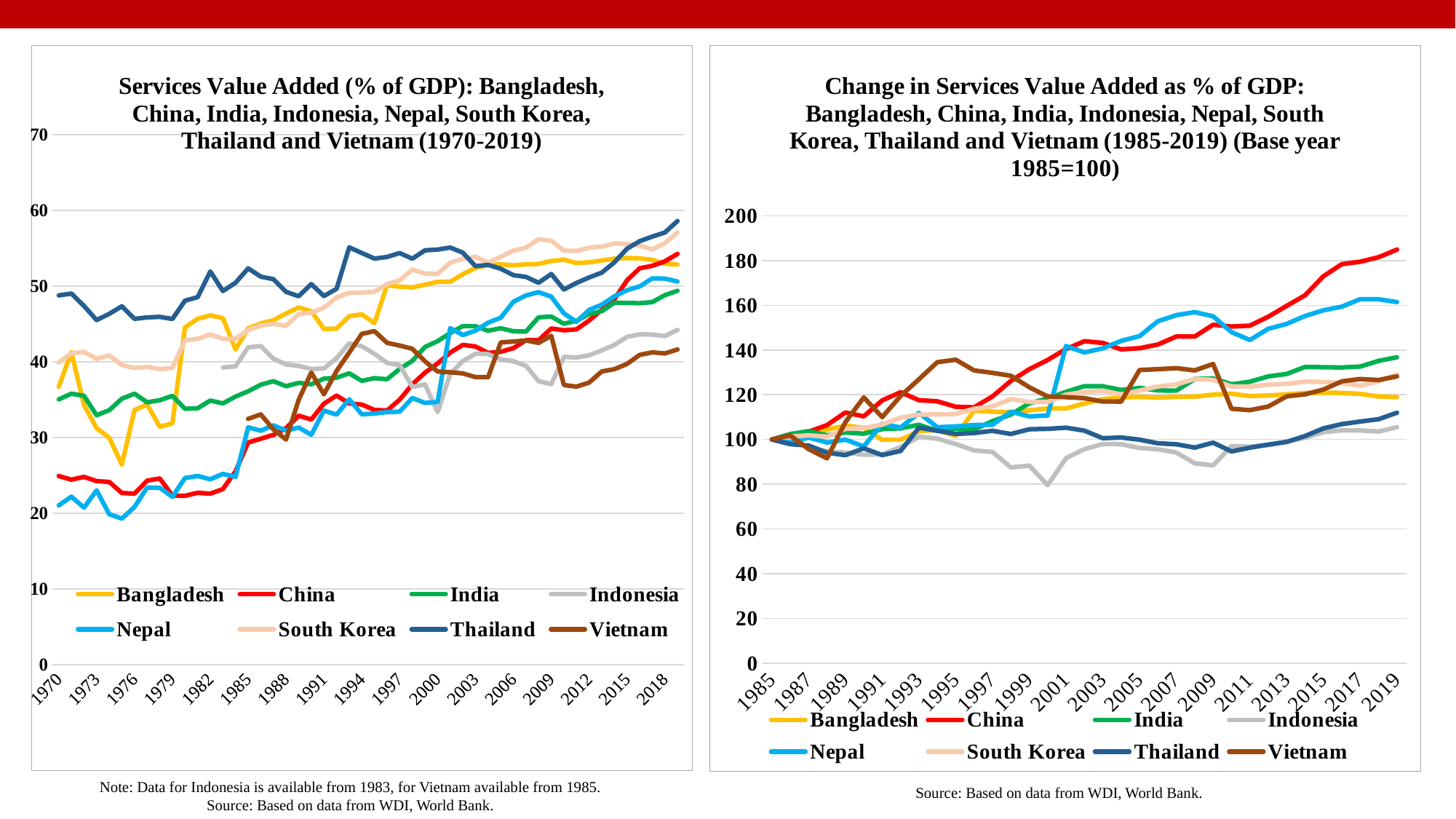
In the right chart, 'Change in Services Value Added as % of GDP', is the value for Indonesia in 2009 greater or less than 100? less In the right chart, 'Change in Services Value Added as % of GDP', which country has the lowest value in 2019? Indonesia In the right chart, 'Change in Services Value Added as % of GDP', is the value for China in 2019 greater or less than 180? greater What kind of chart is the left chart, 'Services Value Added (% of GDP)'? line chart How many series does the legend of the right chart, 'Change in Services Value Added as % of GDP', list? 8 In the left chart, 'Services Value Added (% of GDP)', is the value for China in 1970 greater or less than 30? less In the right chart, 'Change in Services Value Added as % of GDP', which country has the highest value in 2019? China In the left chart, 'Services Value Added (% of GDP)', does the value for China generally rise or fall from 1985 to 2019? rise In the left chart, 'Services Value Added (% of GDP)', which country has the highest value in 1970? Thailand In the left chart, 'Services Value Added (% of GDP)', which country has the lowest value in 1970? Nepal In the right chart, 'Change in Services Value Added as % of GDP', which is larger in 2019: the value for Nepal or the value for Thailand? Nepal